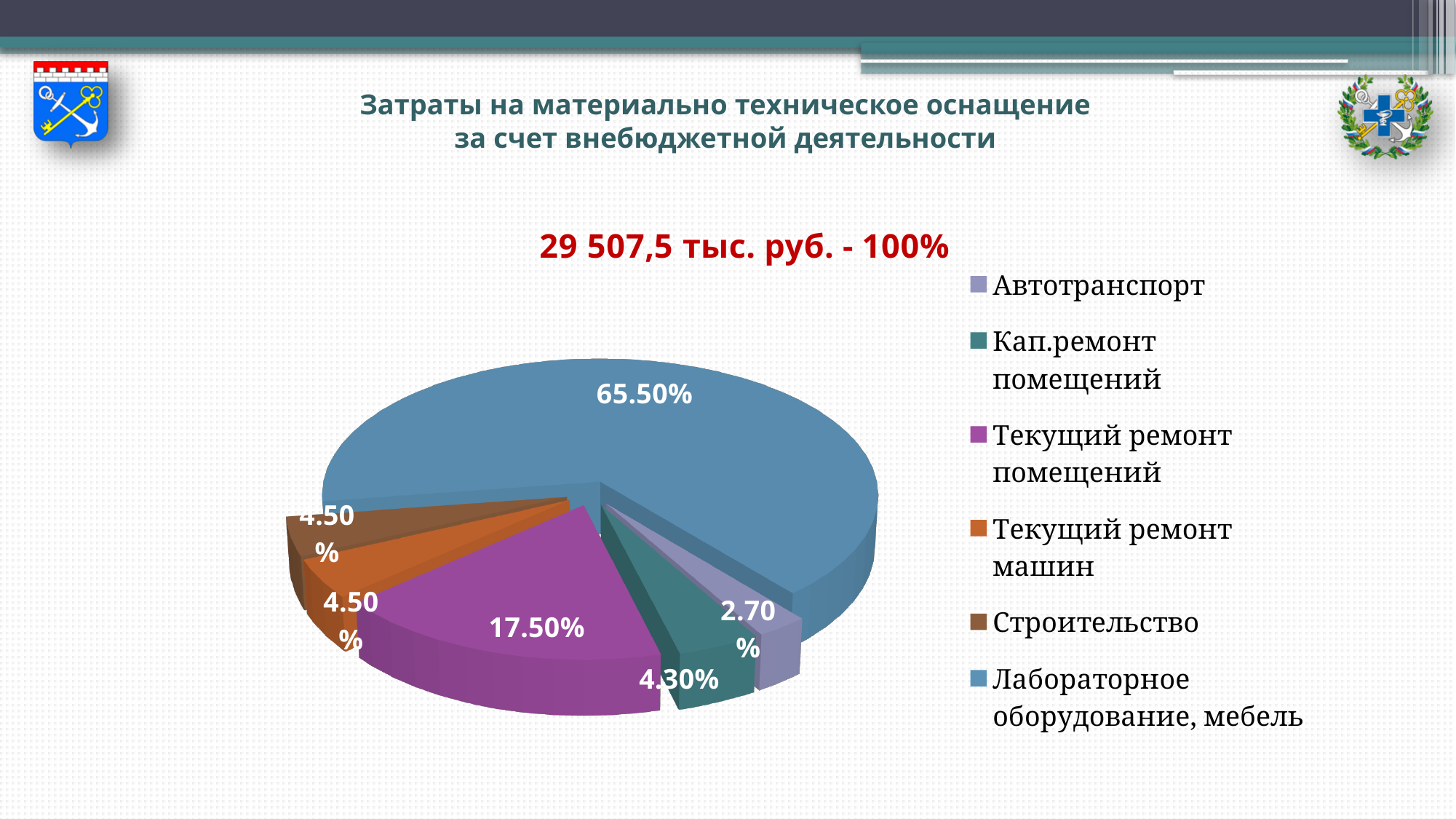
Which category has the smallest slice of the pie? Автотранспорт What share of the pie does Кап.ремонт помещений have? 4.30% What share of the pie does Лабораторное оборудование, мебель have? 65.50% What share of the pie does Строительство have? 4.50% What total amount in thousand rubles is stated above the chart as 100%? 29 507,5 тыс. руб. Which is larger: the slice for Кап.ремонт помещений or the slice for Автотранспорт? Кап.ремонт помещений How many entries does the legend list? 6 What kind of chart is shown on the slide? pie chart What share of the pie does Автотранспорт have? 2.70% What share of the pie does Текущий ремонт помещений have? 17.50% Which category has the largest slice of the pie? Лабораторное оборудование, мебель What is the difference in percentage points between Лабораторное оборудование, мебель and Текущий ремонт помещений? 48 percentage points